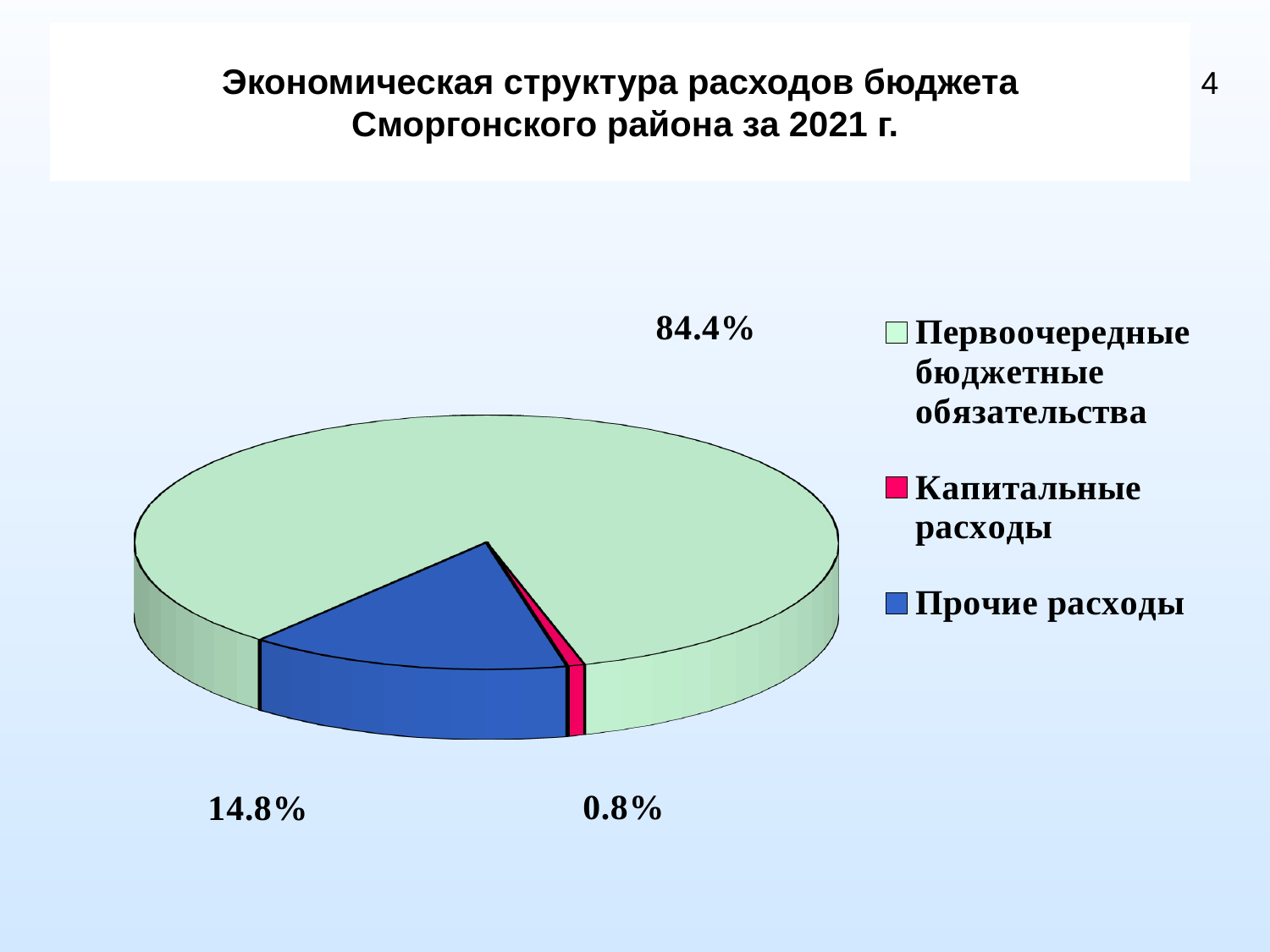
What colour is the slice for "Капитальные расходы"? Red What is the title of the chart on the slide? Экономическая структура расходов бюджета Сморгонского района за 2021 г. What is the difference in percentage points between "Первоочередные бюджетные обязательства" and "Прочие расходы"? 69.6 What share of the pie does "Прочие расходы" have? 14.8% What kind of chart is shown on the slide? Pie chart Which category has the largest slice of the pie? Первоочередные бюджетные обязательства Which category has the smallest slice of the pie? Капитальные расходы What share of the pie does "Капитальные расходы" have? 0.8% How many categories does the pie chart have? 3 What share of the pie does "Первоочередные бюджетные обязательства" have? 84.4% What is the difference in percentage points between "Прочие расходы" and "Капитальные расходы"? 14.0 Which is larger: the share of "Прочие расходы" or the share of "Капитальные расходы"? Прочие расходы